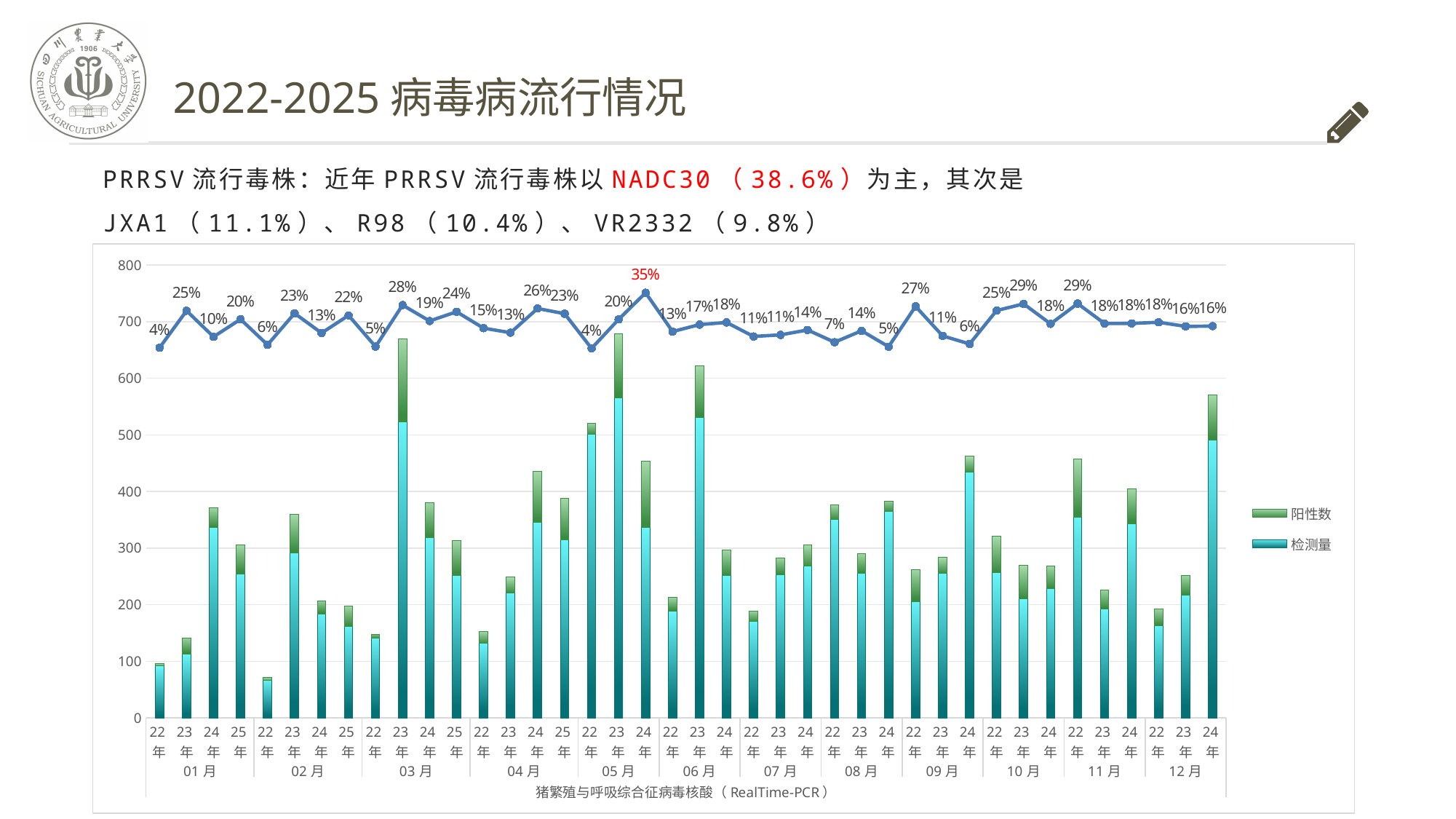
Is the total height of the stacked bar for 24年 in 12月 greater or less than 500? greater How many series does the legend list? 2 Which has the higher percentage on the line: 24年 in 05月 or 22年 in 06月? 24年 in 05月 What kind of chart is this? Stacked bar chart with a line By how many percentage points does the line value for 23年 in 03月 (28%) exceed the value for 22年 in 01月 (4%)? 24 What is the percentage label on the line for 23年 in 10月? 29% What is the percentage label on the line for 23年 in 03月? 28% How many month groups are shown on the x axis? 12 Which year-month point has the highest percentage on the line? 24年 in 05月 (35%) Is the total height of the stacked bar for 23年 in 03月 greater or less than 600? greater What is the percentage label on the line for 24年 in 09月? 6%